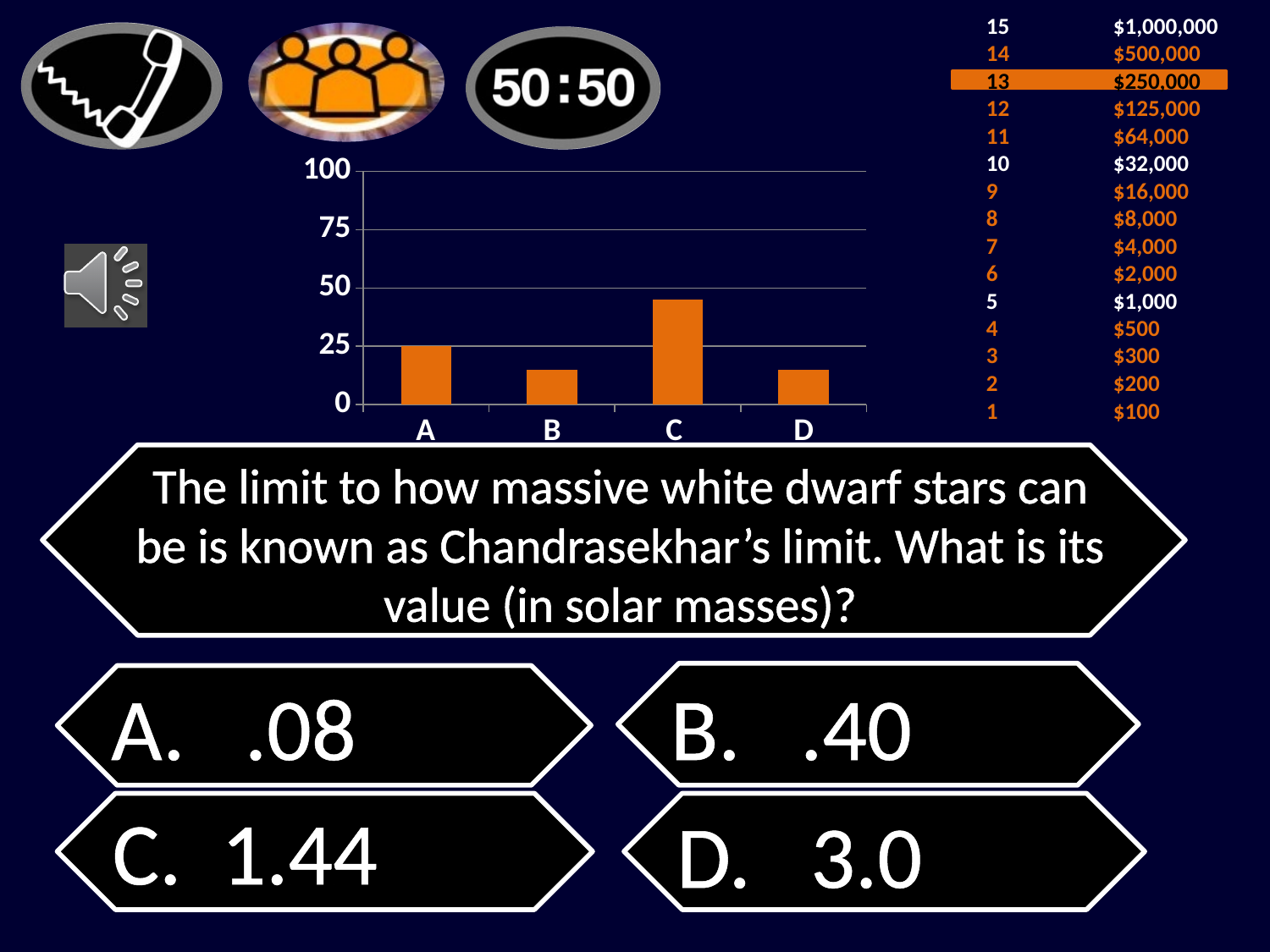
Which is larger, the value for A or the value for B? A Is the value for D greater or less than 25? less What kind of chart is shown on the slide? bar chart Is the value for B greater or less than 25? less Which category has the highest bar in the chart? C What is the value for A in the bar chart? 25 How many categories are shown on the x axis of the bar chart? 4 Is the value for C greater or less than 25? greater What colour are the bars in the chart? orange Which is larger, the value for C or the value for A? C What is the highest value shown on the y axis of the chart? 100